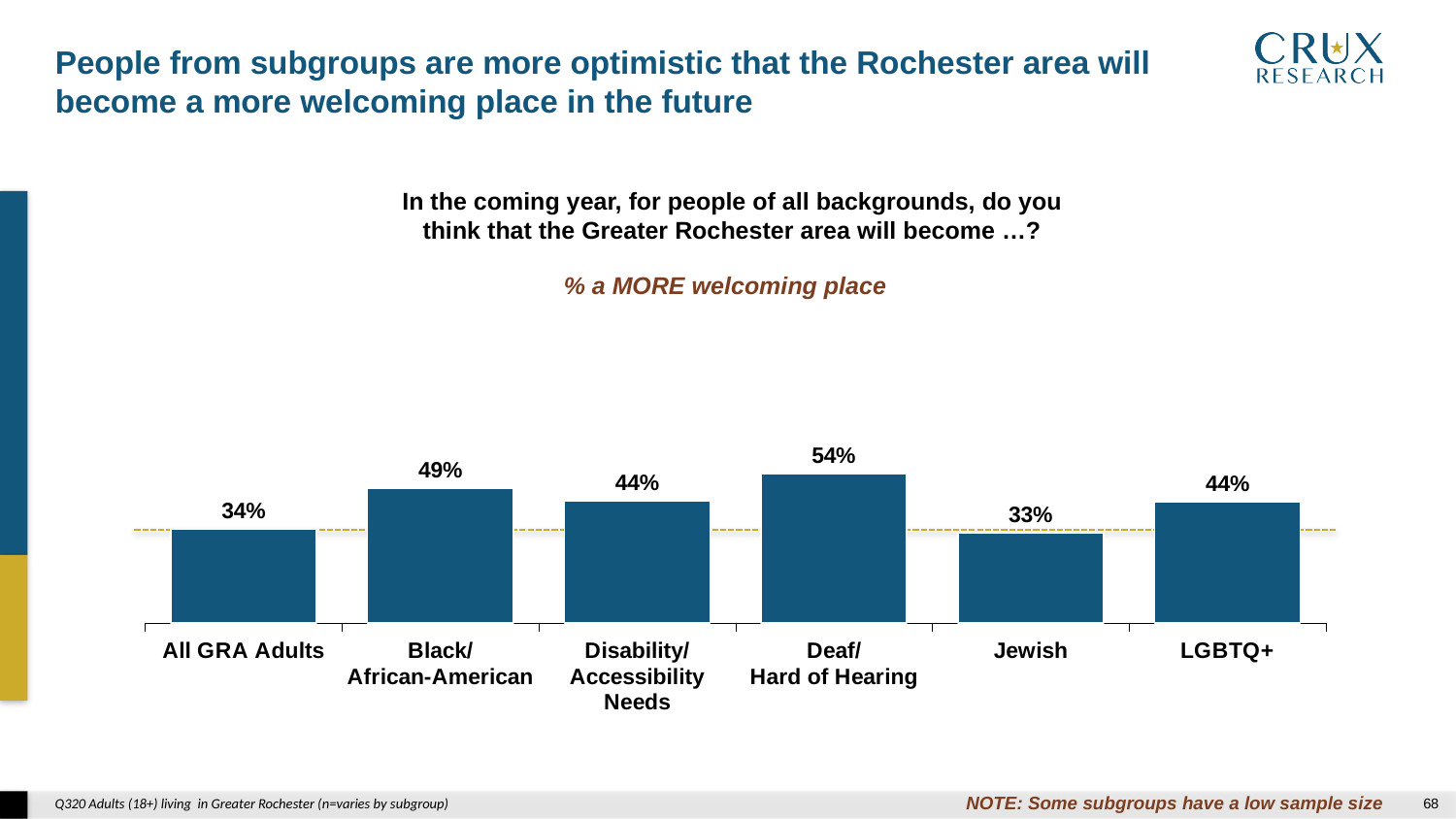
What is the subtitle printed in italics above the chart? % a MORE welcoming place What kind of chart is shown on the slide? Bar chart Which subgroup has the highest percentage saying the area will become a more welcoming place? Deaf/Hard of Hearing What is the value shown for the Black/African-American subgroup? 49% How many categories are shown on the chart? 6 What is the value shown for the Jewish subgroup? 33% Which is larger, the value for LGBTQ+ or the value for All GRA Adults? LGBTQ+ Which category has the lowest value on the chart? Jewish What is the difference between the Black/African-American value and the Jewish value? 16 percentage points What percentage of All GRA Adults think the Greater Rochester area will become a more welcoming place? 34% What is the value shown for the Deaf/Hard of Hearing subgroup? 54% What is the difference between the Deaf/Hard of Hearing value and the All GRA Adults value? 20 percentage points